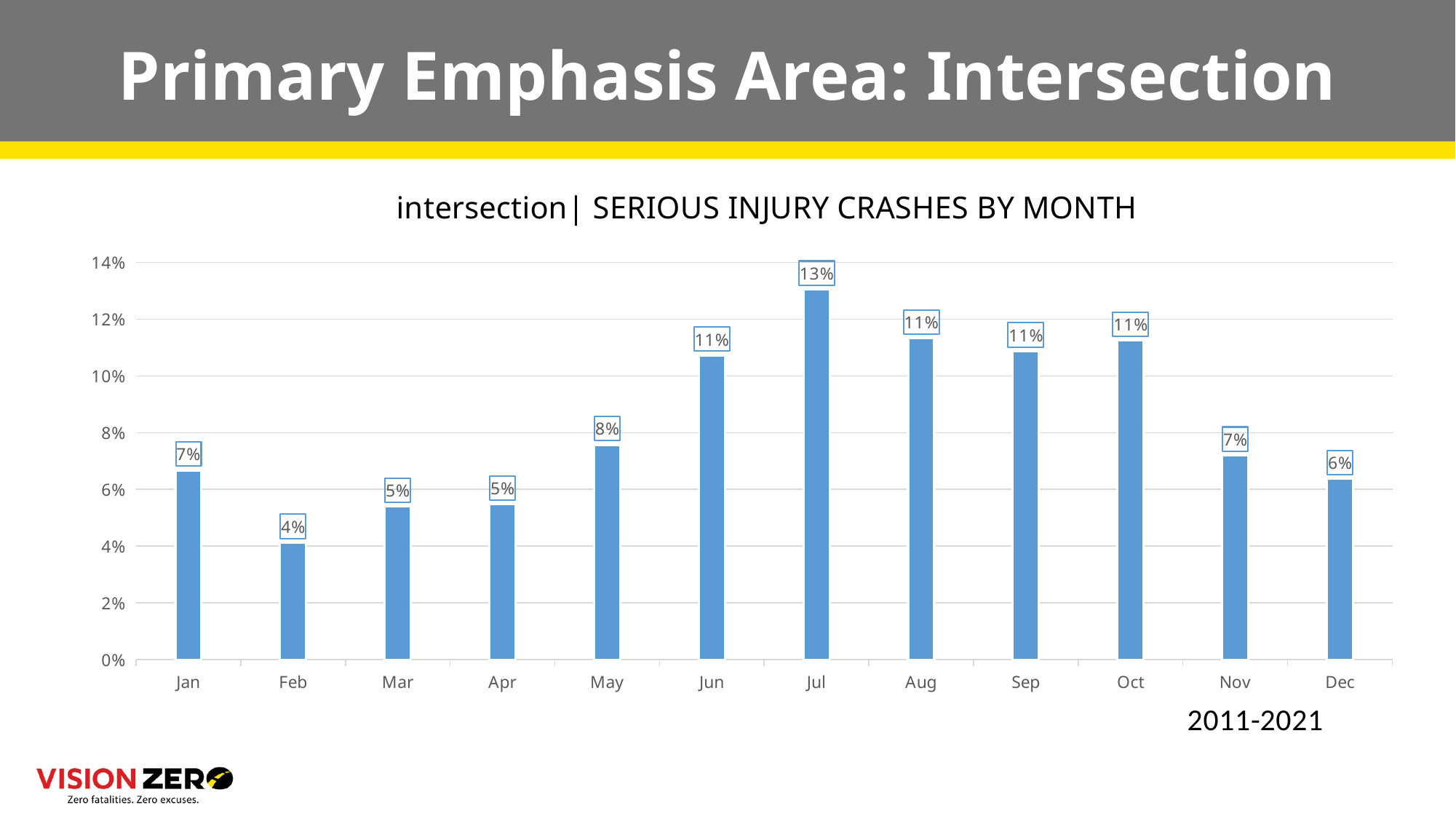
What is the value for Feb? 4% What kind of chart is this? Bar chart What is the value for May? 8% What is the difference between the values for Jul and Feb? 9% Which is larger, the value for May or the value for Nov? May What is the value for Dec? 6% Is the value for Jun greater or less than 10%? greater How many months are shown on the x axis? 12 Which month has the lowest value? Feb What is the value for Jul? 13% What is the title of the chart? intersection| SERIOUS INJURY CRASHES BY MONTH Which month has the highest value? Jul